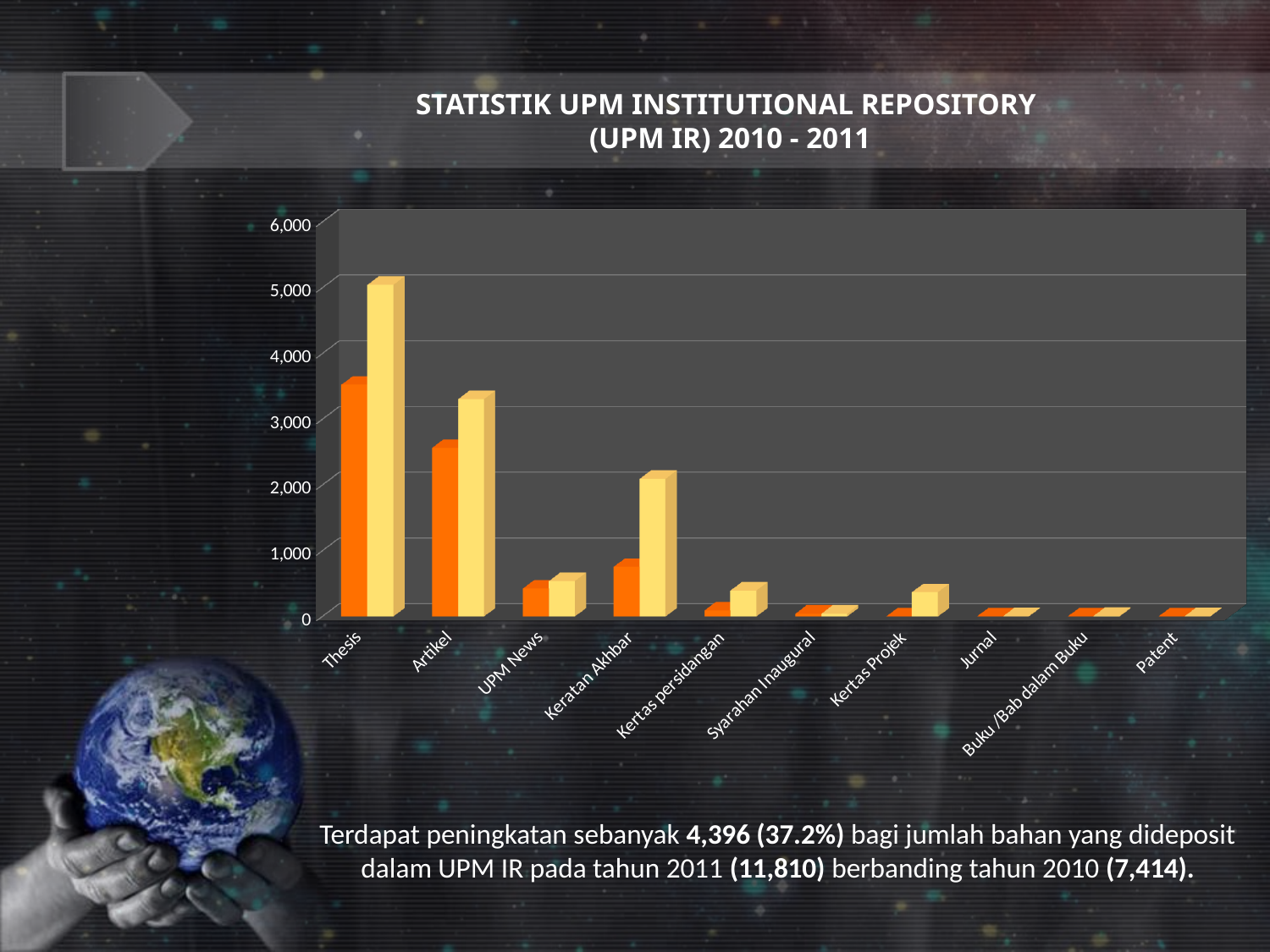
How many categories are shown on the x axis of the chart? 10 Is the value of the orange bar for Thesis greater or less than 3,000? greater Is the value of the yellow bar for UPM News greater or less than 1,000? less Do the bar values generally rise or fall from left to right along the x axis? fall Which has the taller yellow bar, Thesis or Artikel? Thesis Is the value of the orange bar for Artikel greater or less than 2,000? greater What kind of chart is shown on the slide? bar chart Which has the taller yellow bar, Keratan Akhbar or UPM News? Keratan Akhbar Which category has the tallest bars in the chart? Thesis